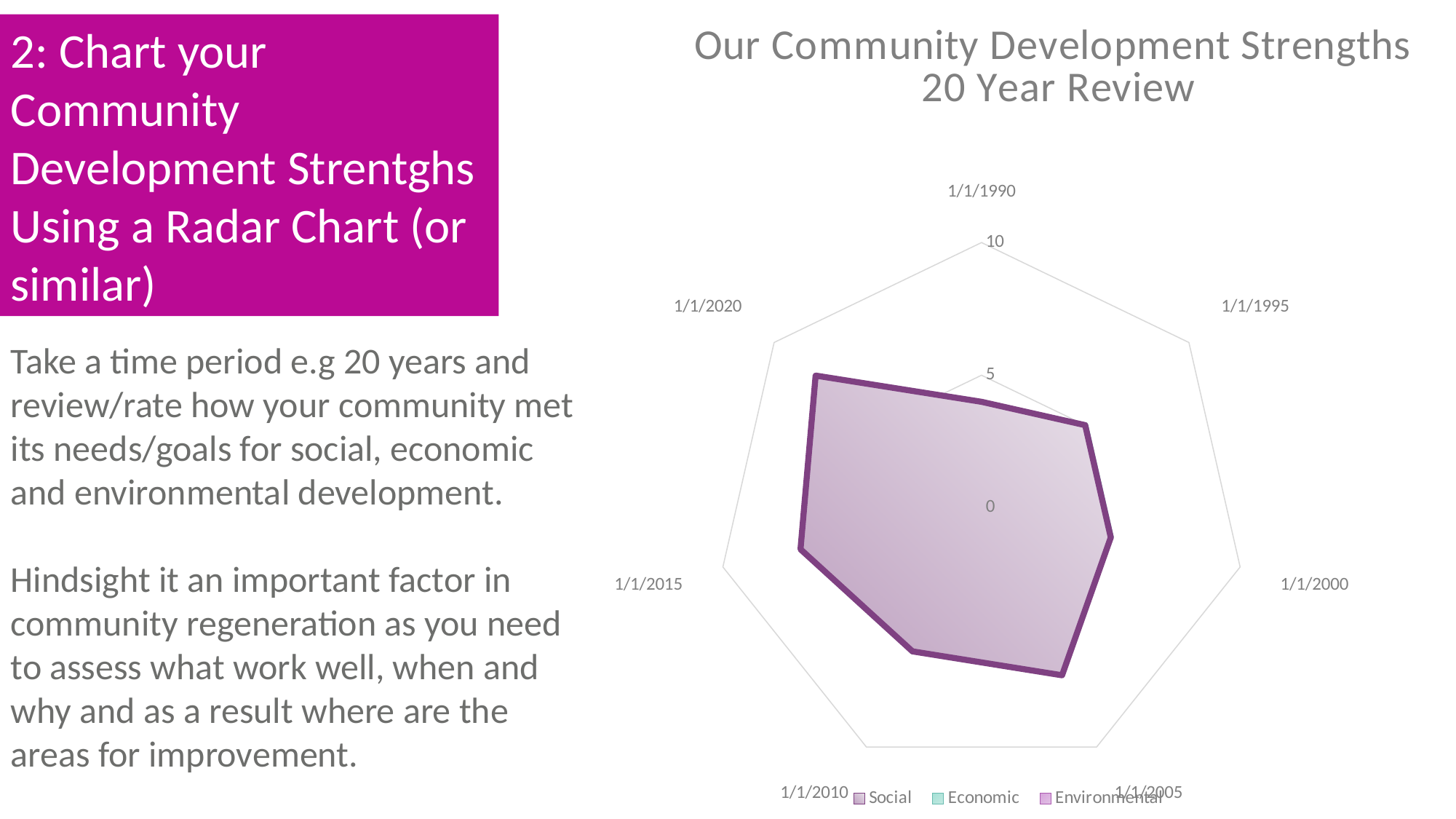
What kind of chart is shown on the slide? Radar chart What is the title of the chart? Our Community Development Strengths 20 Year Review Which is larger, the plotted value for 1/1/2015 or for 1/1/1990? 1/1/2015 How many series does the chart legend list? 3 Is the plotted value for 1/1/2015 greater or less than 5? greater Is the plotted value for 1/1/2020 greater or less than 5? greater Which date category has the highest plotted value on the radar chart? 1/1/2020 Is the plotted value for 1/1/1990 greater or less than 5? less Which is larger, the plotted value for 1/1/2020 or for 1/1/1990? 1/1/2020 What are the series names listed in the chart legend? Social, Economic, Environmental How many date categories are plotted around the radar chart? 7